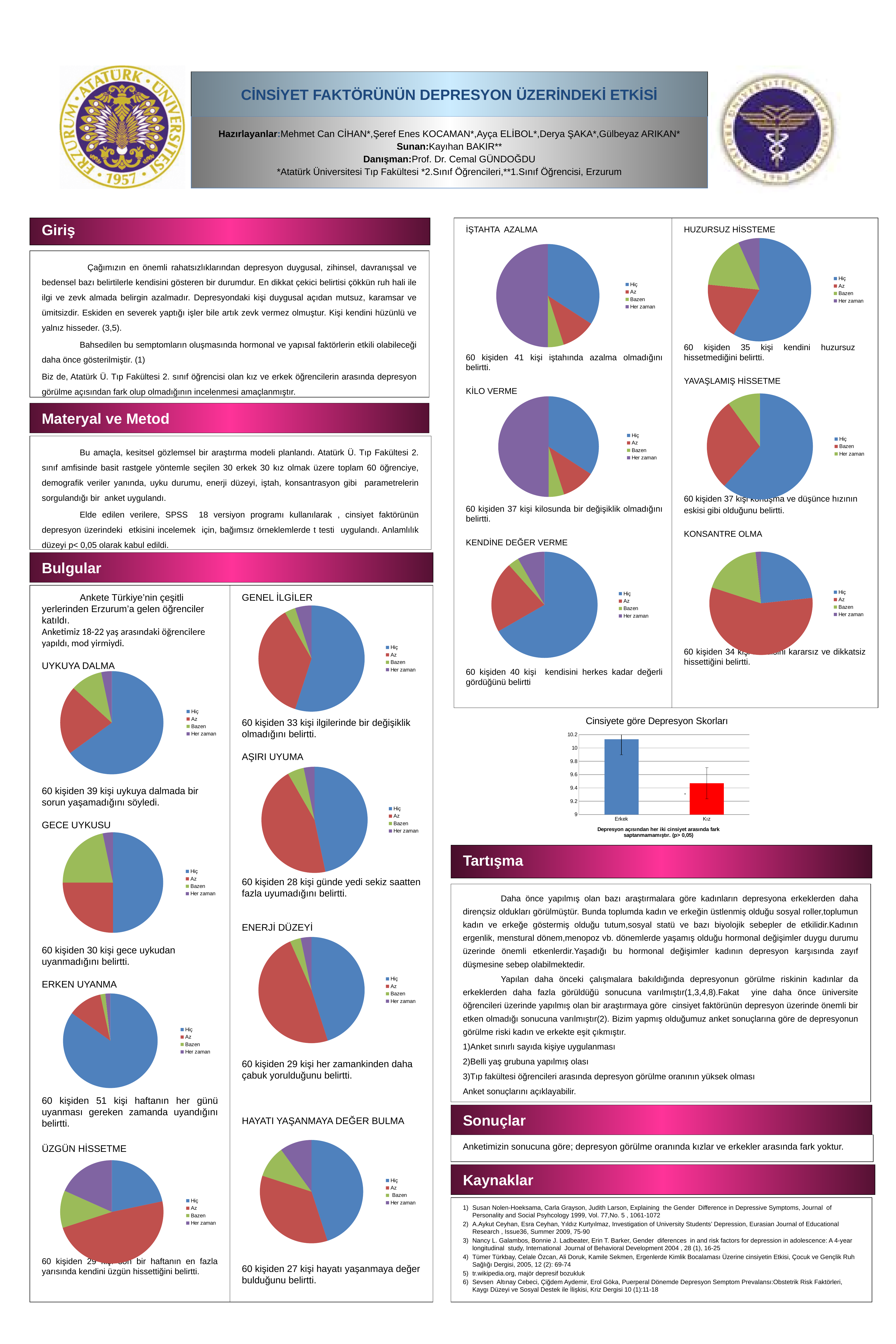
In the 'Cinsiyete göre Depresyon Skorları' chart, which category has the higher value, Erkek or Kız? Erkek In the 'KENDİNE DEĞER VERME' pie chart, which category has the largest slice? Hiç What kind of chart is the 'Cinsiyete göre Depresyon Skorları' chart? bar chart In the 'KONSANTRE OLMA' pie chart, which category has the largest slice? Az In the 'Cinsiyete göre Depresyon Skorları' chart, is the value for Kız greater or less than 9.6? less How many categories does the legend of the 'YAVAŞLAMIŞ HİSSETME' pie chart list? 3 In the 'Cinsiyete göre Depresyon Skorları' chart, how many categories are shown on the x axis? 2 In the 'Cinsiyete göre Depresyon Skorları' chart, is the value for Erkek greater or less than 10? greater What are the legend entries of the 'GECE UYKUSU' pie chart? Hiç, Az, Bazen, Her zaman What kind of chart is the 'UYKUYA DALMA' chart? pie chart In the 'ERKEN UYANMA' pie chart, which category has the smallest slice? Bazen and Her zaman (tied) In the 'UYKUYA DALMA' pie chart, which category has the largest slice? Hiç